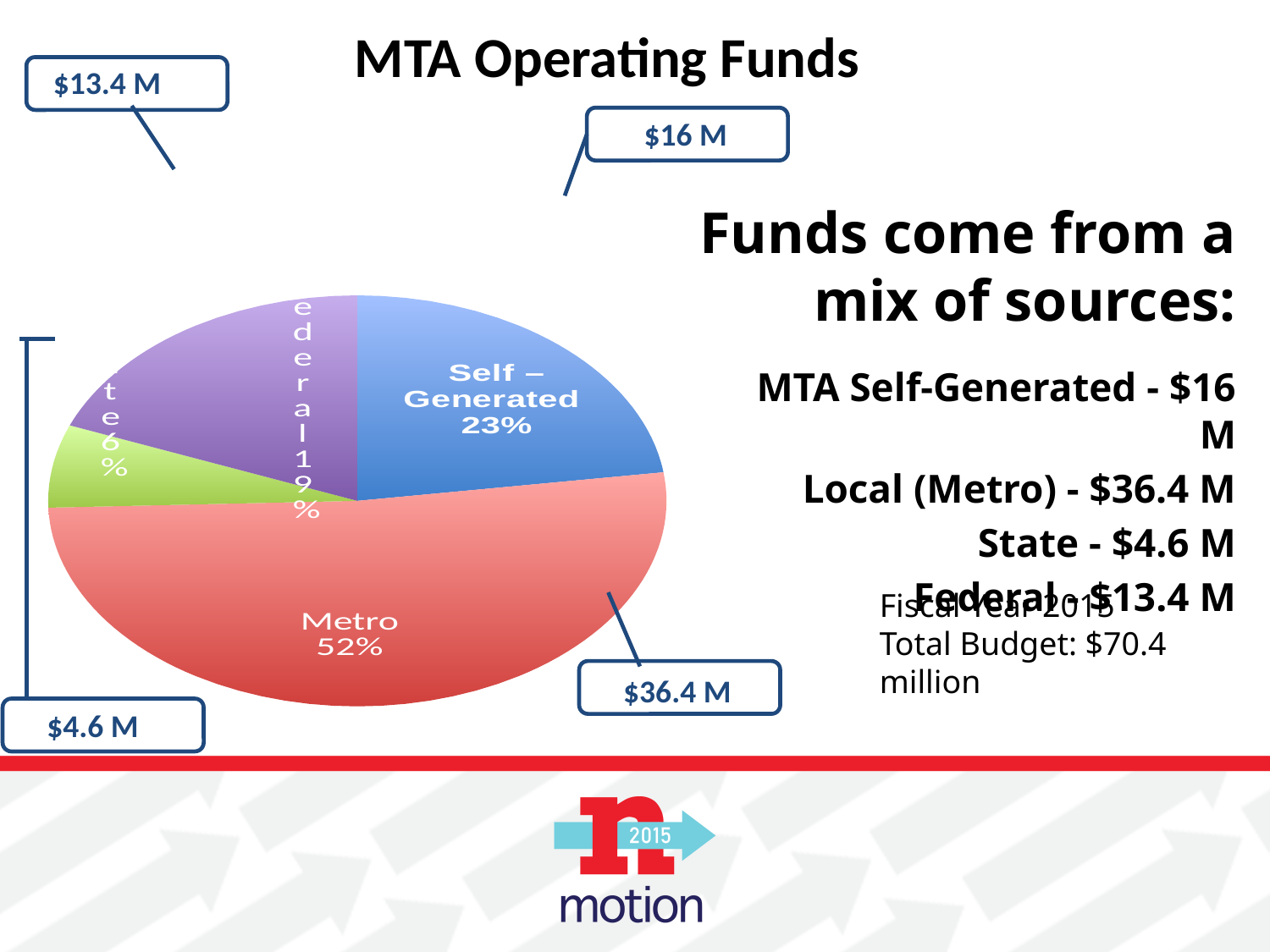
What percentage of the pie is Self-Generated? 23% What percentage of MTA operating funds comes from Metro? 52% Which funding source has the largest slice of the pie? Metro What share of the pie is Federal? 19% What dollar amount is shown in the callout for the Metro slice? $36.4 M How many slices does the pie chart have? 4 What kind of chart is shown on the slide? pie chart By how many percentage points does the Metro share exceed the Self-Generated share? 29 percentage points What is the title of the chart? MTA Operating Funds What dollar amount is shown in the callout for the Federal slice? $13.4 M Which funding source has the smallest slice of the pie? State Which slice is larger, Self-Generated or Federal? Self-Generated